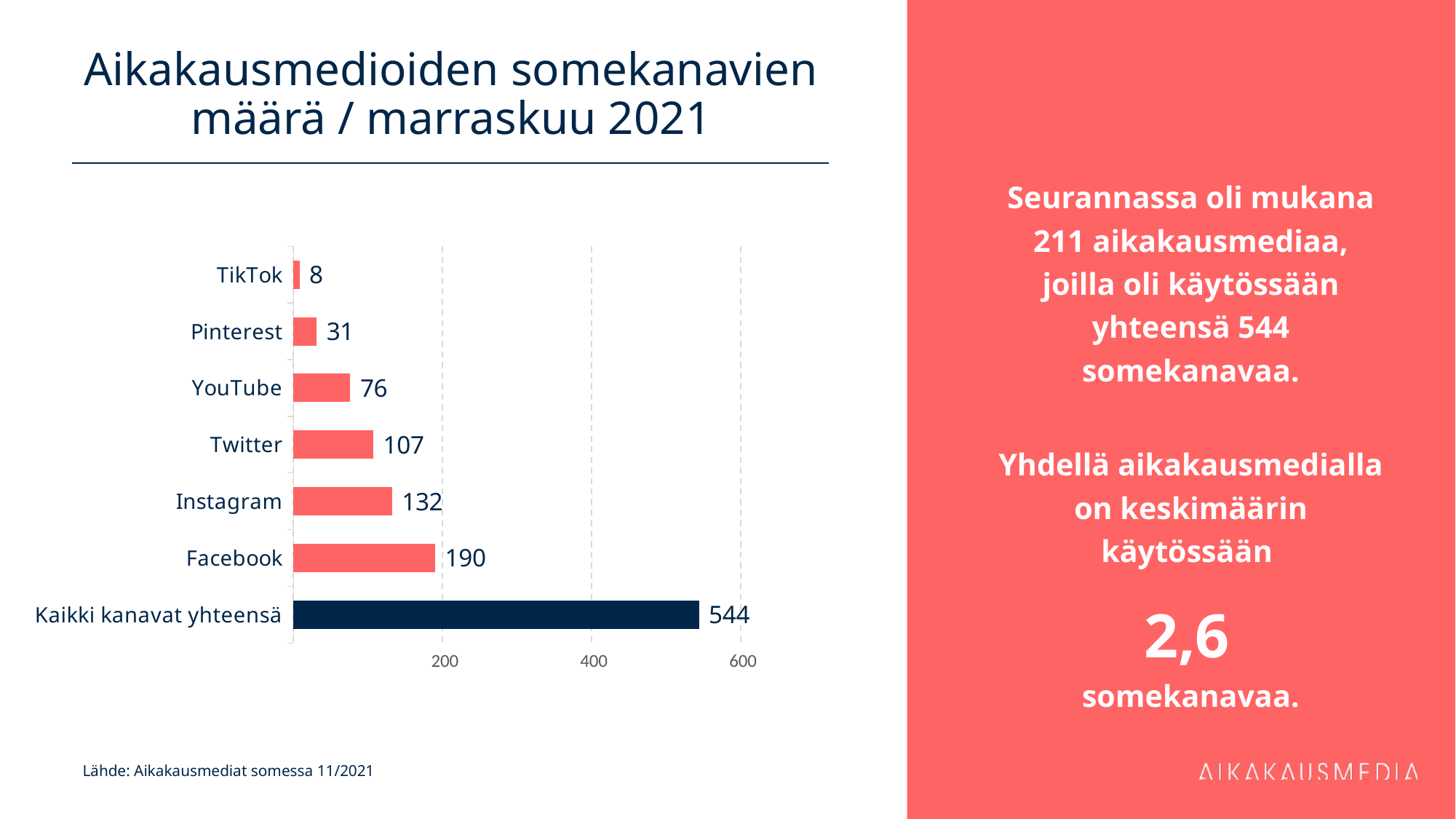
Which individual channel (excluding the total bar) has the highest value? Facebook What is the value for Instagram? 132 What is the value for TikTok? 8 What is the value for Facebook? 190 How many bars are shown in the chart? 7 What is the difference between the values for Twitter and YouTube? 31 What colour is the bar for Kaikki kanavat yhteensä? Dark navy blue What is the value for Kaikki kanavat yhteensä? 544 Which is larger, the value for Pinterest or the value for YouTube? YouTube What is the difference between the values for Facebook and Instagram? 58 Which category has the lowest value? TikTok What kind of chart is shown on the slide? Bar chart